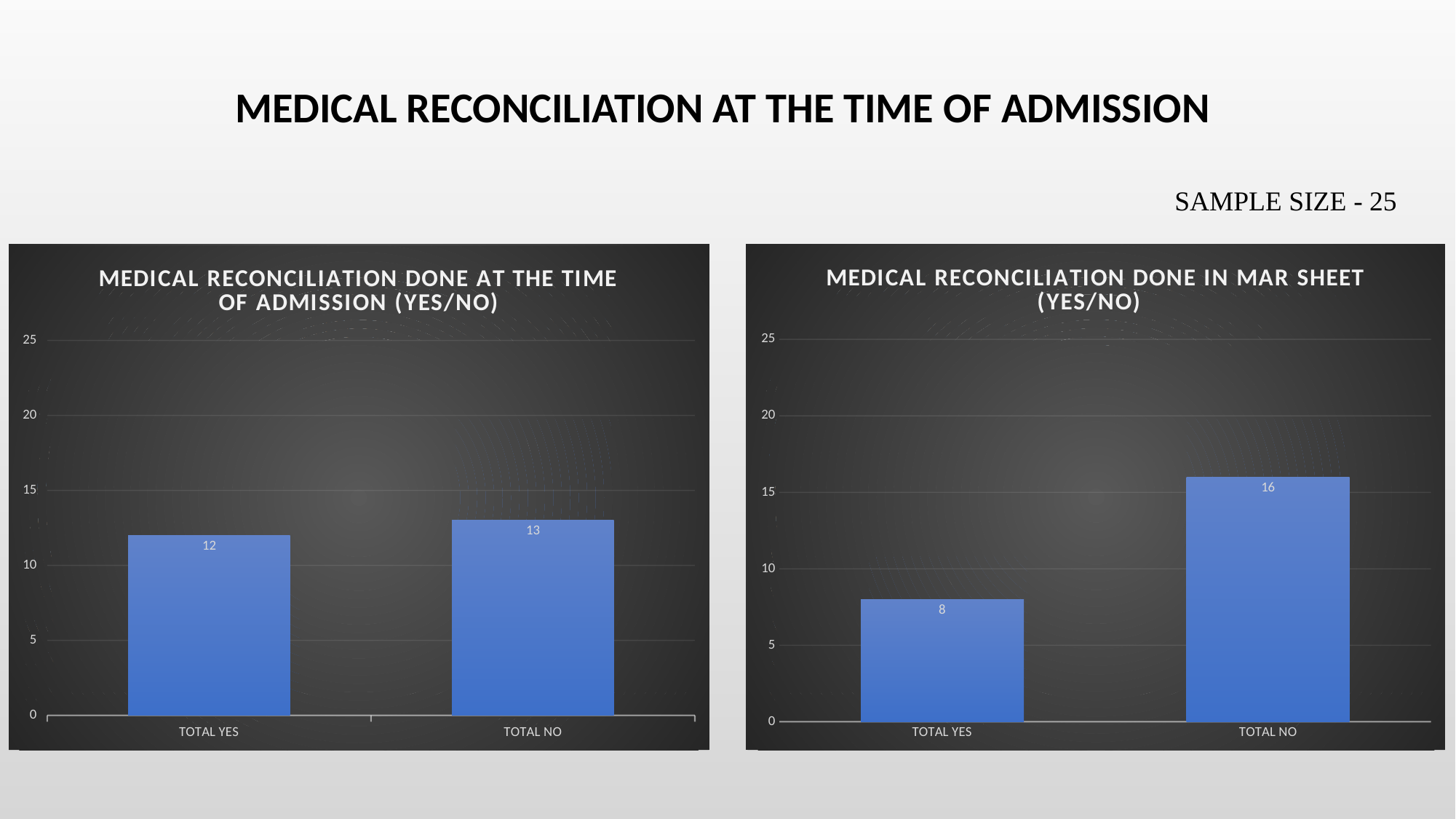
What is the title of the left chart? Medical Reconciliation Done at the Time of Admission (Yes/No) In the left chart (Medical Reconciliation Done at the Time of Admission), what is the difference between TOTAL NO and TOTAL YES? 1 In the right chart (Medical Reconciliation Done in MAR Sheet), what is the difference between TOTAL NO and TOTAL YES? 8 What kind of chart is the right chart (Medical Reconciliation Done in MAR Sheet)? Bar chart In the left chart (Medical Reconciliation Done at the Time of Admission), what is the value for TOTAL YES? 12 How many categories are shown in the left chart (Medical Reconciliation Done at the Time of Admission)? 2 In the right chart (Medical Reconciliation Done in MAR Sheet), what is the value for TOTAL NO? 16 In the right chart (Medical Reconciliation Done in MAR Sheet), is the value for TOTAL NO greater or less than 15? greater In the right chart (Medical Reconciliation Done in MAR Sheet), what is the value for TOTAL YES? 8 In the left chart (Medical Reconciliation Done at the Time of Admission), what is the value for TOTAL NO? 13 In the right chart (Medical Reconciliation Done in MAR Sheet), which category has the highest value? TOTAL NO In the right chart (Medical Reconciliation Done in MAR Sheet), which category has the lowest value? TOTAL YES